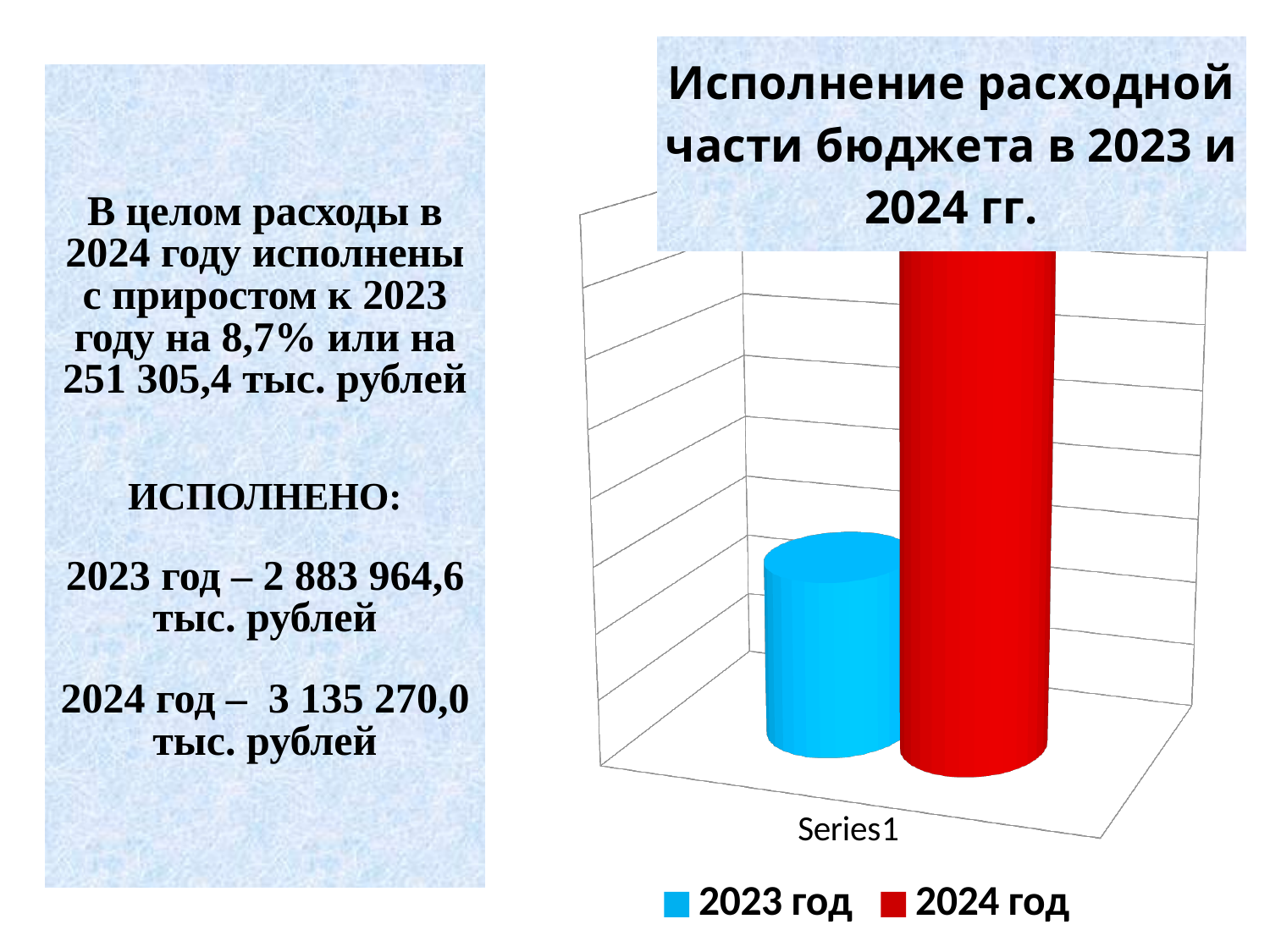
How many categories are shown on the x axis? 1 How many series does the legend list? 2 What is the label of the category on the x axis? Series1 What is the title of the chart? Исполнение расходной части бюджета в 2023 и 2024 гг. Which series has the shorter bar? 2023 год Which colour represents 2023 год in the legend? blue Is the bar for 2024 год taller or shorter than the bar for 2023 год? taller Which series has the taller bar, 2023 год or 2024 год? 2024 год What kind of chart is shown on the slide? bar chart